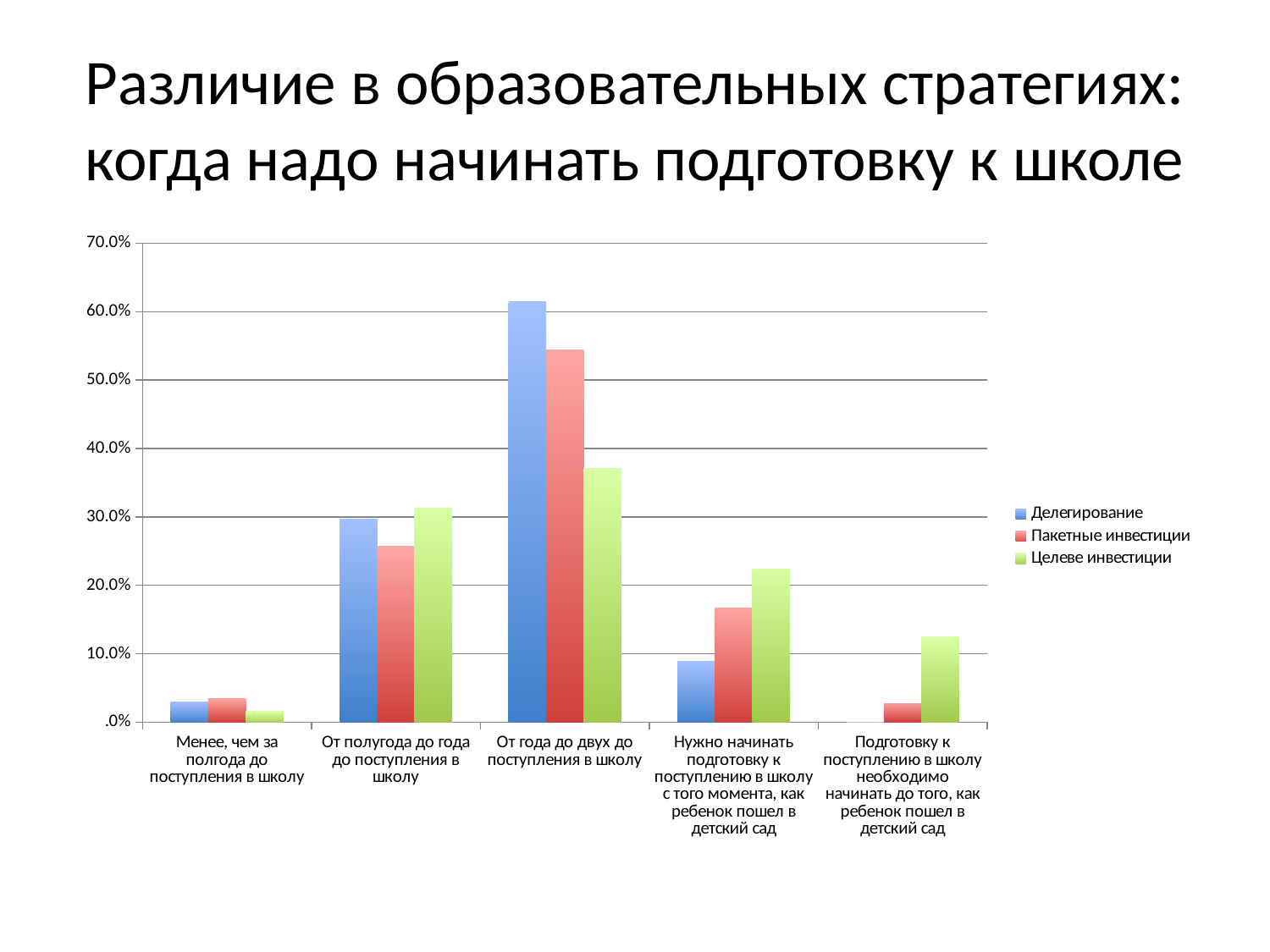
For the series Целеве инвестиции, which category has the lowest value? Менее, чем за полгода до поступления в школу In the category Нужно начинать подготовку к поступлению в школу с того момента, как ребенок пошел в детский сад, which is larger: Делегирование or Целеве инвестиции? Целеве инвестиции What colour represents the series Целеве инвестиции in the legend? Green For the series Делегирование, which category has the highest value? От года до двух до поступления в школу How many categories are shown on the x axis? 5 Is the value for Целеве инвестиции in the category Подготовку к поступлению в школу необходимо начинать до того, как ребенок пошел в детский сад greater or less than 10.0%? greater Is the value for Целеве инвестиции in the category От года до двух до поступления в школу greater or less than 40.0%? less Is the value for Делегирование in the category От года до двух до поступления в школу greater or less than 50.0%? greater In the category От года до двух до поступления в школу, which is larger: Делегирование or Пакетные инвестиции? Делегирование How many series does the legend list? 3 What kind of chart is shown on the slide? Bar chart